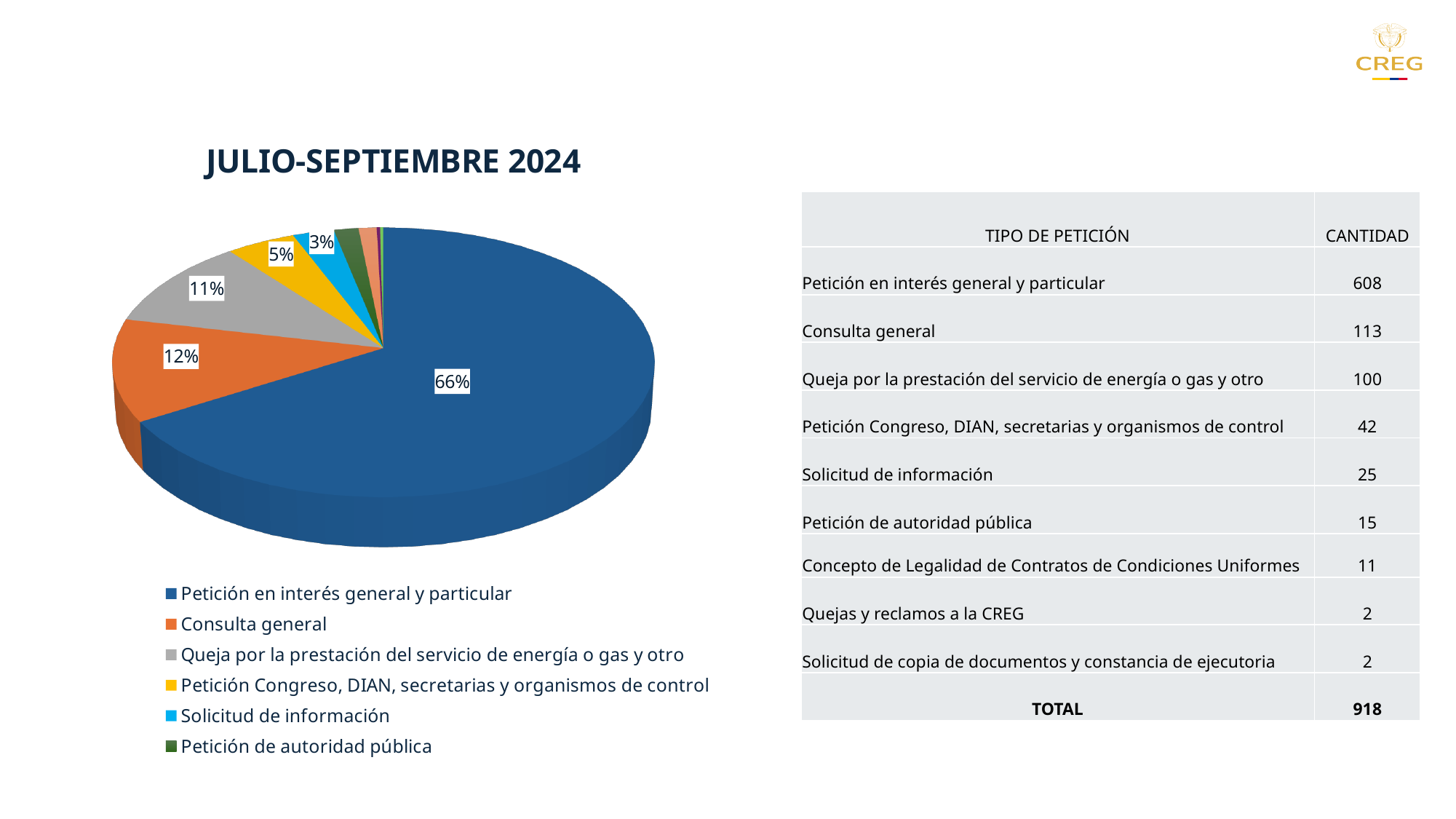
What percentage share does the pie chart show for Solicitud de información? 3% What percentage share does the pie chart show for Consulta general? 12% What percentage share does the pie chart show for Petición Congreso, DIAN, secretarias y organismos de control? 5% By how many percentage points does the share of Petición en interés general y particular exceed the share of Consulta general in the pie chart? 54 percentage points Which slice is larger in the pie chart: Consulta general or Queja por la prestación del servicio de energía o gas y otro? Consulta general What percentage share does the pie chart show for Queja por la prestación del servicio de energía o gas y otro? 11% What percentage share does the pie chart show for Petición en interés general y particular? 66% Which category has the largest slice in the pie chart? Petición en interés general y particular What colour is the slice for Petición en interés general y particular in the pie chart? Blue How many entries does the pie chart's legend list? 6 What kind of chart is shown on the slide? Pie chart What is the title of the pie chart? JULIO-SEPTIEMBRE 2024